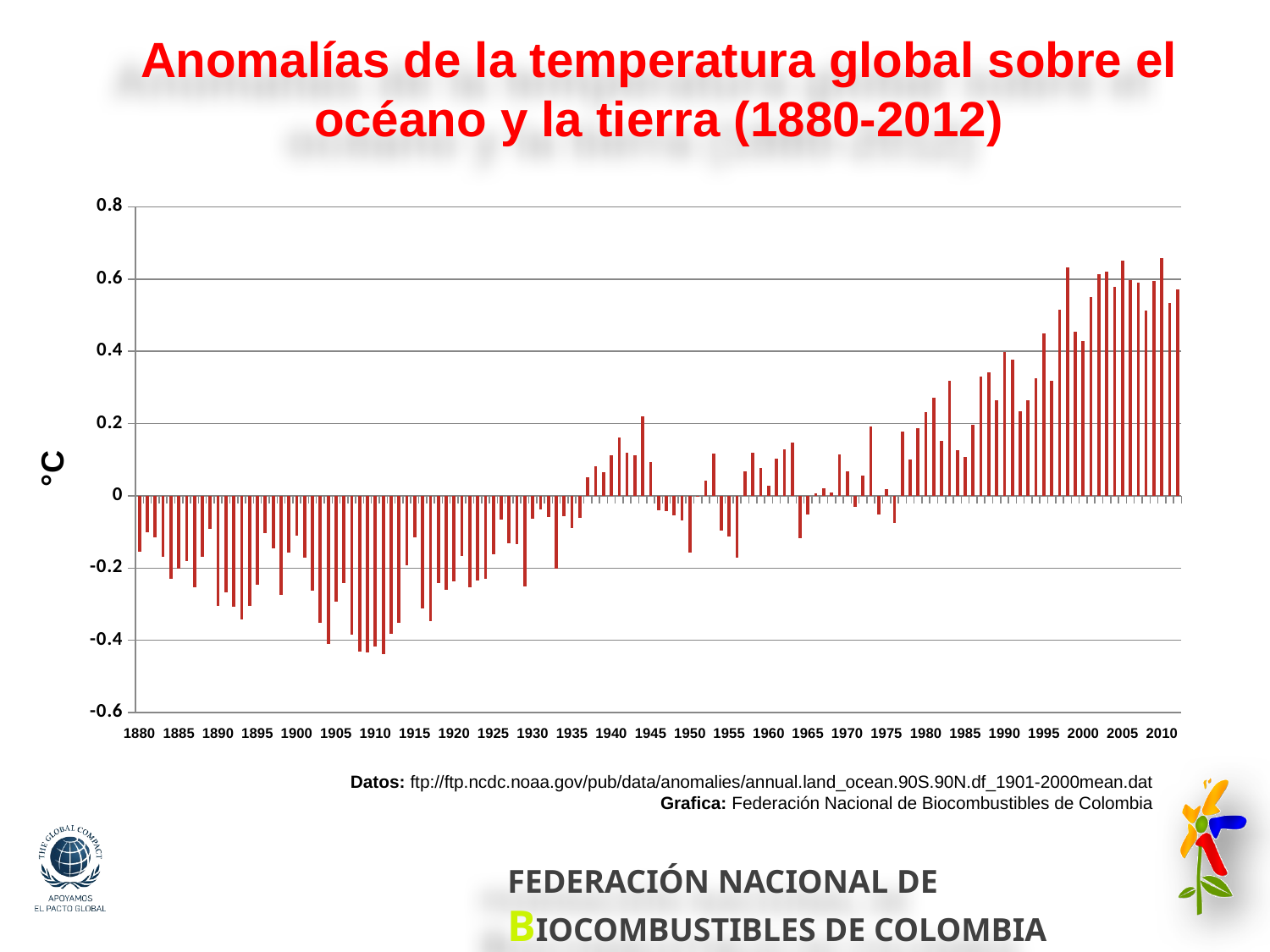
Which year has the larger value, 1910 or 2010? 2010 Is the value for 1880 greater or less than 0? less What unit is shown on the y-axis label of the chart? °C Which year has the larger value, 1945 or 1950? 1945 Is the value for 1900 greater or less than 0.2? less Is the value for 2010 greater or less than 0.4? greater What kind of chart is shown on the slide? bar chart What is the title of the chart? Anomalías de la temperatura global sobre el océano y la tierra (1880-2012) Overall, do the temperature anomaly values rise or fall from 1880 to 2012? rise